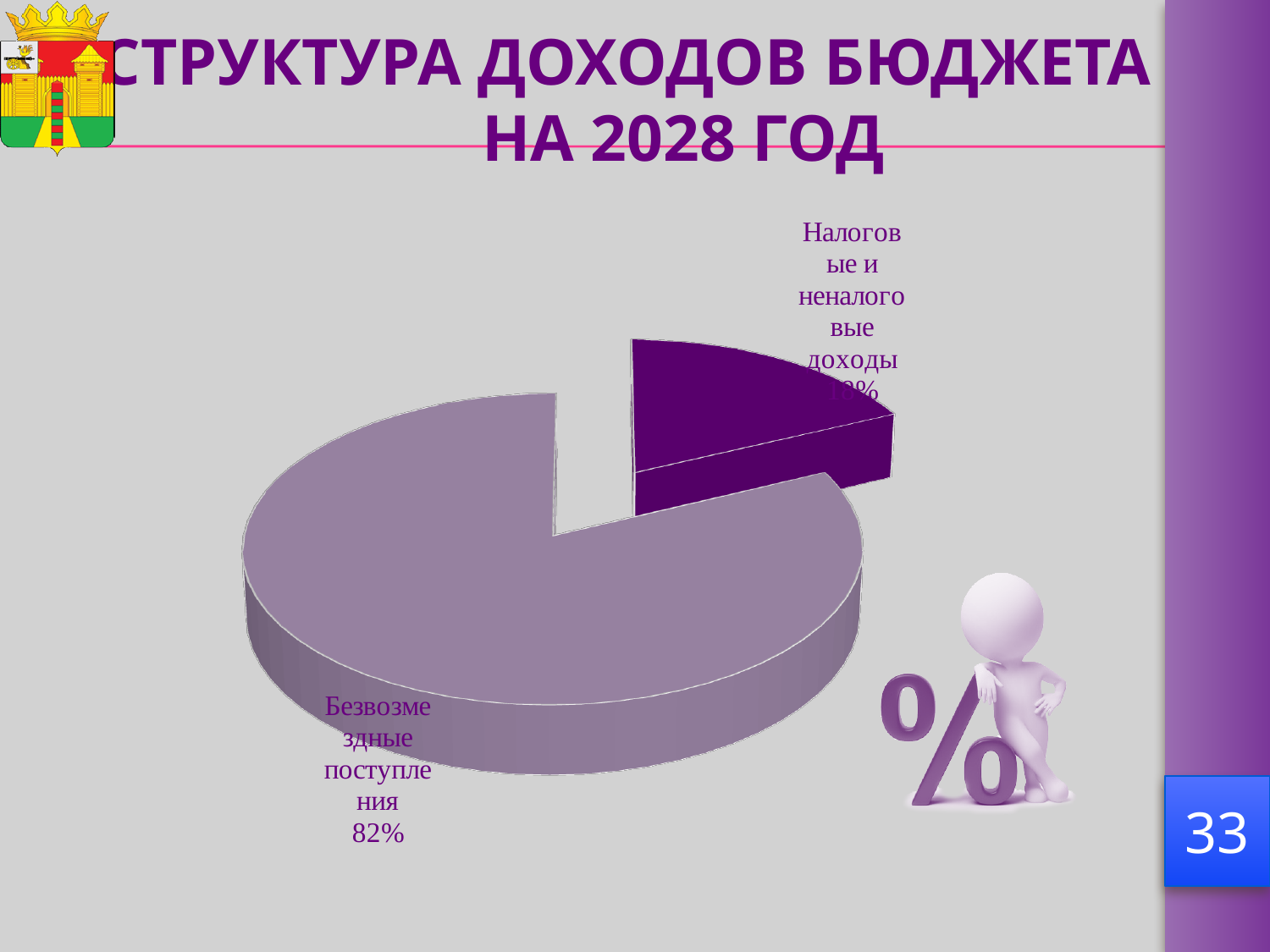
Which is larger: Безвозмездные поступления or Налоговые и неналоговые доходы? Безвозмездные поступления Is the share for Безвозмездные поступления greater or less than 50%? greater Is the share for Налоговые и неналоговые доходы greater or less than 50%? less What share of the pie is labelled for Безвозмездные поступления? 82% Which slice is shown in the dark purple colour? Налоговые и неналоговые доходы Which slice of the pie chart is the smallest? Налоговые и неналоговые доходы What is the title of the chart on the slide? СТРУКТУРА ДОХОДОВ БЮДЖЕТА НА 2028 ГОД How many slices does the pie chart have? 2 Which slice of the pie chart is the largest? Безвозмездные поступления What type of chart is shown on the slide? pie chart